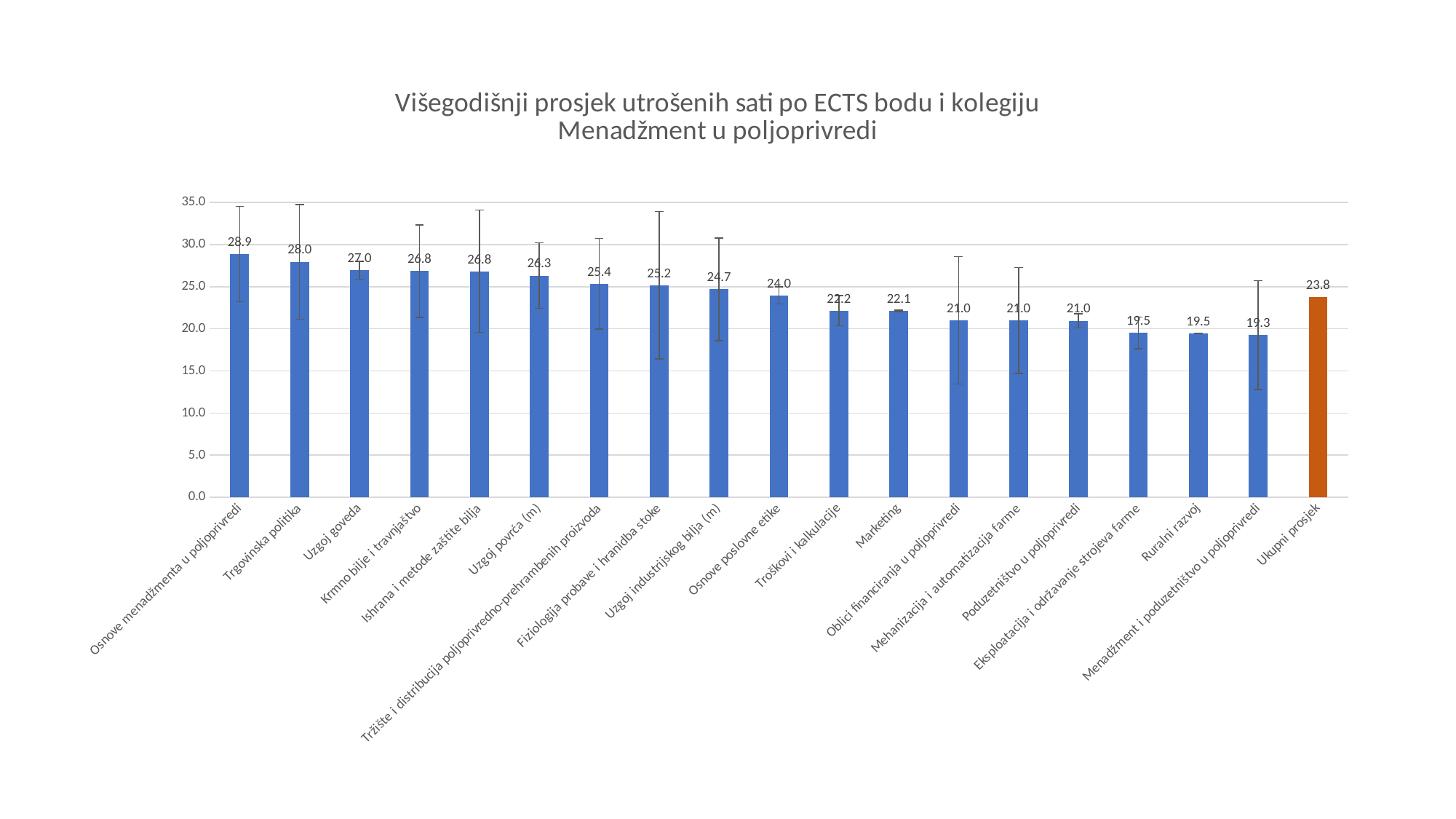
Is the value for Fiziologija probave i hranidba stoke greater or less than 25.0? greater What is the difference between the values for Osnove menadžmenta u poljoprivredi and Ukupni prosjek? 5.1 Which is larger, the value for Uzgoj goveda or the value for Osnove poslovne etike? Uzgoj goveda Which category has the lowest value? Menadžment i poduzetništvo u poljoprivredi Which category has the highest value? Osnove menadžmenta u poljoprivredi What kind of chart is this? bar chart What is the value for Marketing? 22.1 How many categories are shown on the x axis? 19 What is the value for Ukupni prosjek? 23.8 What is the value for Trgovinska politika? 28.0 Which bar is coloured differently from the others? Ukupni prosjek Do the values of the blue bars rise or fall from left to right along the x axis? fall